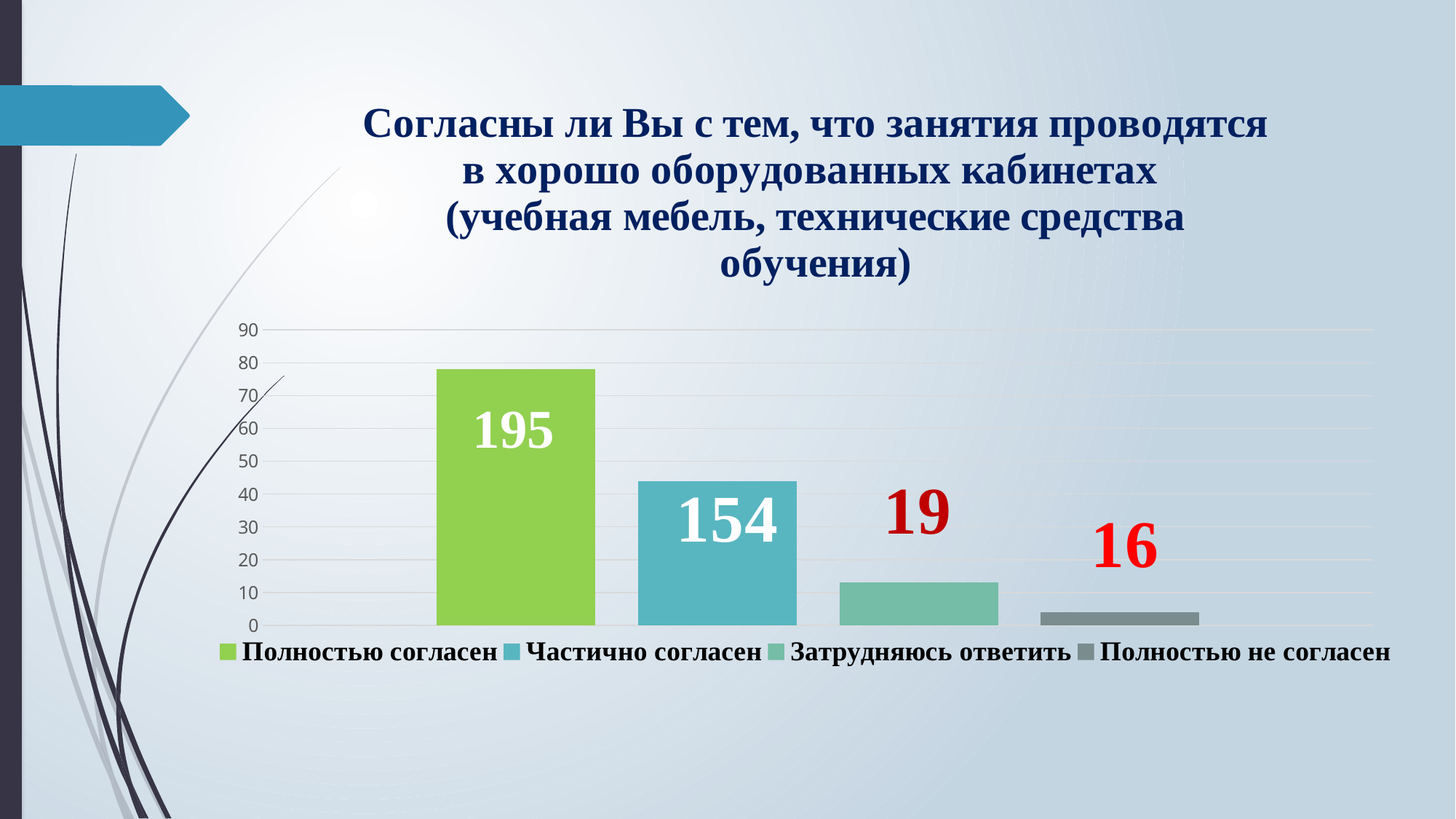
Which category has the lowest value? Полностью не согласен What kind of chart is shown on the slide? bar chart How many categories does the legend list? 4 What is the difference between the values for "Затрудняюсь ответить" and "Полностью не согласен"? 3 What is the value for "Полностью не согласен"? 16 What is the value for "Частично согласен"? 154 What is the value for "Затрудняюсь ответить"? 19 Which is larger, the value for "Частично согласен" or the value for "Затрудняюсь ответить"? Частично согласен What is the value for "Полностью согласен"? 195 What is the difference between the values for "Полностью согласен" and "Частично согласен"? 41 Do the values rise or fall from left to right across the bars? fall Which category has the highest value? Полностью согласен